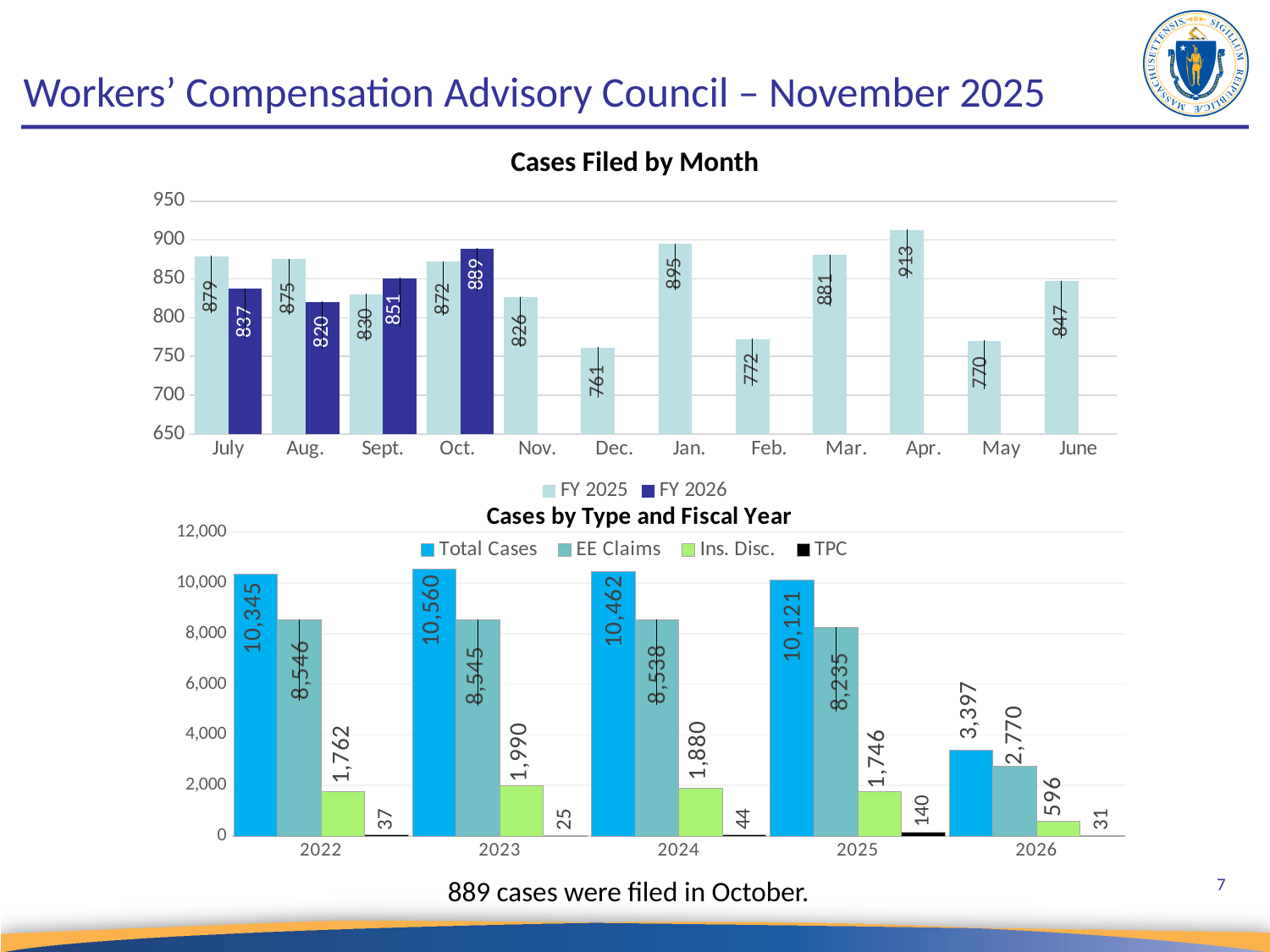
In the 'Cases by Type and Fiscal Year' chart, what is the TPC value for 2025? 140 In the 'Cases Filed by Month' chart, which month has the highest FY 2025 value? Apr. What kind of chart is 'Cases by Type and Fiscal Year'? Bar chart In the 'Cases by Type and Fiscal Year' chart, what is the Total Cases value for 2023? 10,560 In the 'Cases Filed by Month' chart, which is larger for September: FY 2025 or FY 2026? FY 2026 In the 'Cases by Type and Fiscal Year' chart, what is the difference between Ins. Disc. in 2023 and in 2022? 228 In the 'Cases Filed by Month' chart, what is the FY 2026 value for October? 889 In the 'Cases by Type and Fiscal Year' chart, how many fiscal years are shown on the x axis? 5 In the 'Cases Filed by Month' chart, how many series does the legend list? 2 In the 'Cases by Type and Fiscal Year' chart, which year has the lowest EE Claims value? 2026 In the 'Cases Filed by Month' chart, what is the FY 2025 value for December? 761 In the 'Cases Filed by Month' chart, what is the difference between the FY 2025 and FY 2026 values for July? 42